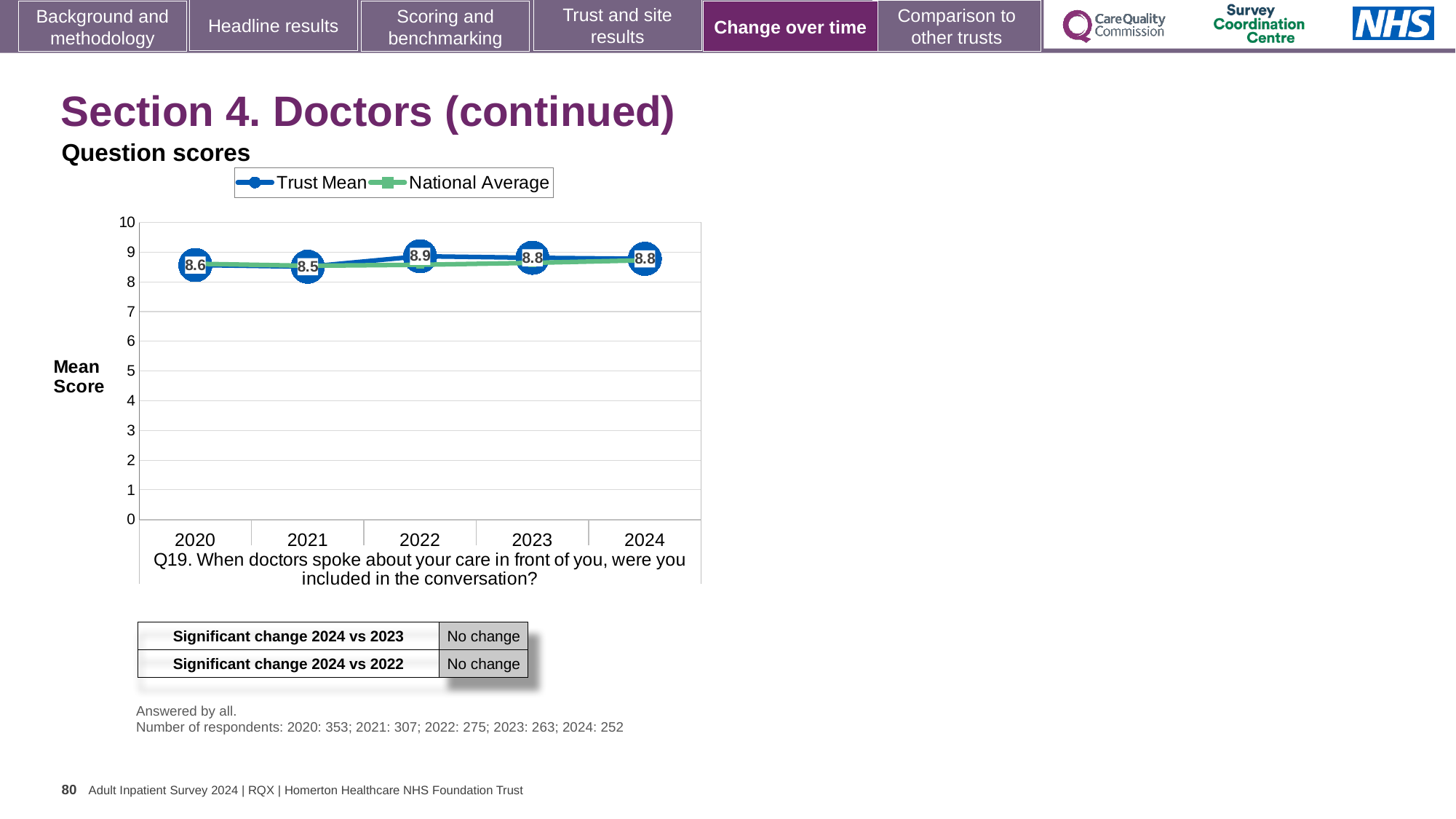
What is the Trust Mean score for 2021? 8.5 What is the Trust Mean score for 2022? 8.9 In which year is the Trust Mean score lowest? 2021 What is the Trust Mean score for 2020? 8.6 Which is larger, the Trust Mean score for 2020 or for 2021? 2020 In which year is the Trust Mean score highest? 2022 How many series does the chart legend list? 2 How many years are shown on the x axis of the chart? 5 What type of chart is shown on the slide? Line chart What is the difference between the Trust Mean score in 2022 and in 2021? 0.4 What is the Trust Mean score for 2024? 8.8 Is the National Average value for 2023 greater or less than 8? greater